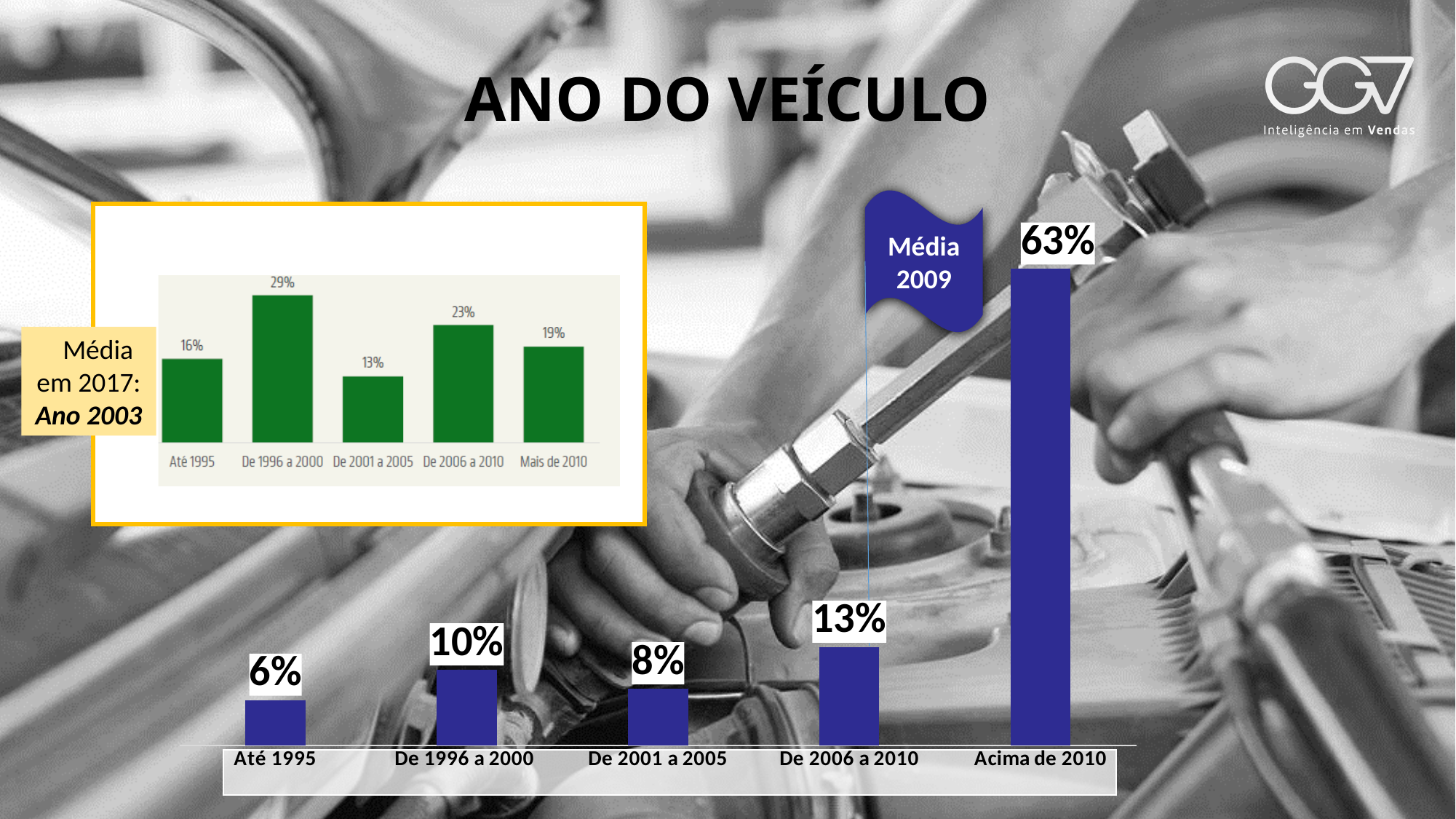
In the large blue bar chart, what is the value for Acima de 2010? 63% In the small green inset chart, what is the value for De 1996 a 2000? 29% In the small green inset chart, what is the value for Mais de 2010? 19% In the large blue bar chart, which category has the highest value? Acima de 2010 In the small green inset chart, what is the difference between the values for De 1996 a 2000 and De 2006 a 2010? 6% In the small green inset chart, which is larger, the value for Até 1995 or the value for De 2006 a 2010? De 2006 a 2010 What type of chart is the large blue chart on the slide? Bar chart In the large blue bar chart, which category has the lowest value? Até 1995 In the large blue bar chart, what is the difference between the values for De 1996 a 2000 and De 2001 a 2005? 2% In the large blue bar chart, what is the value for De 2006 a 2010? 13% In the small green inset chart, which category has the lowest value? De 2001 a 2005 In the large blue bar chart, how many categories are shown? 5